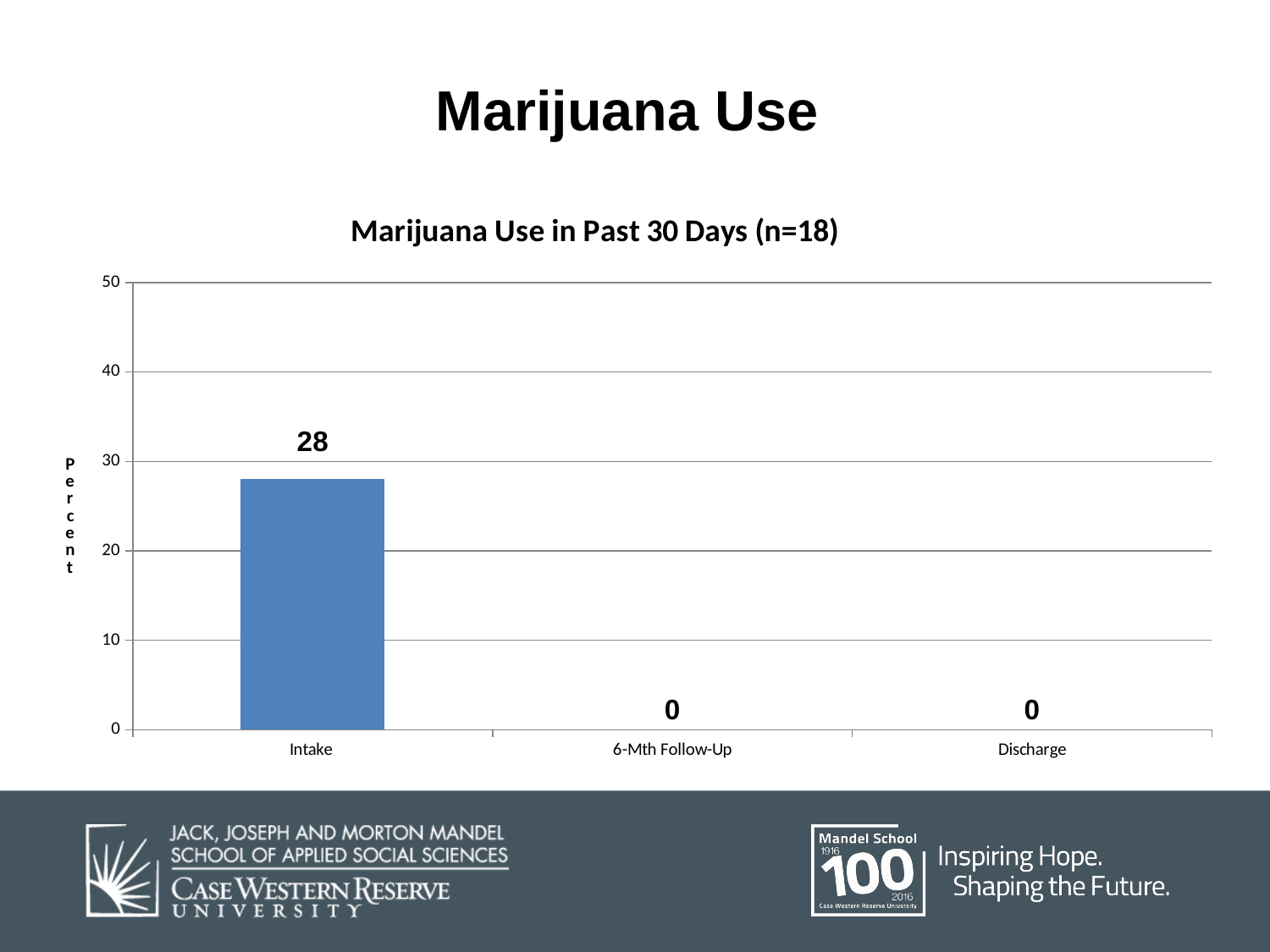
What is the value for Intake? 28 What is the value for Discharge? 0 What is the title of the chart? Marijuana Use in Past 30 Days (n=18) Is the value for Intake greater or less than 20? greater Is the value for Intake greater or less than 30? less What kind of chart is shown? bar chart What is the difference between the Intake value and the Discharge value? 28 What is the value for 6-Mth Follow-Up? 0 Do the values rise or fall from Intake to Discharge? fall Which is larger, the value for Intake or the value for 6-Mth Follow-Up? Intake Which category has the highest value? Intake How many categories are shown on the x axis? 3